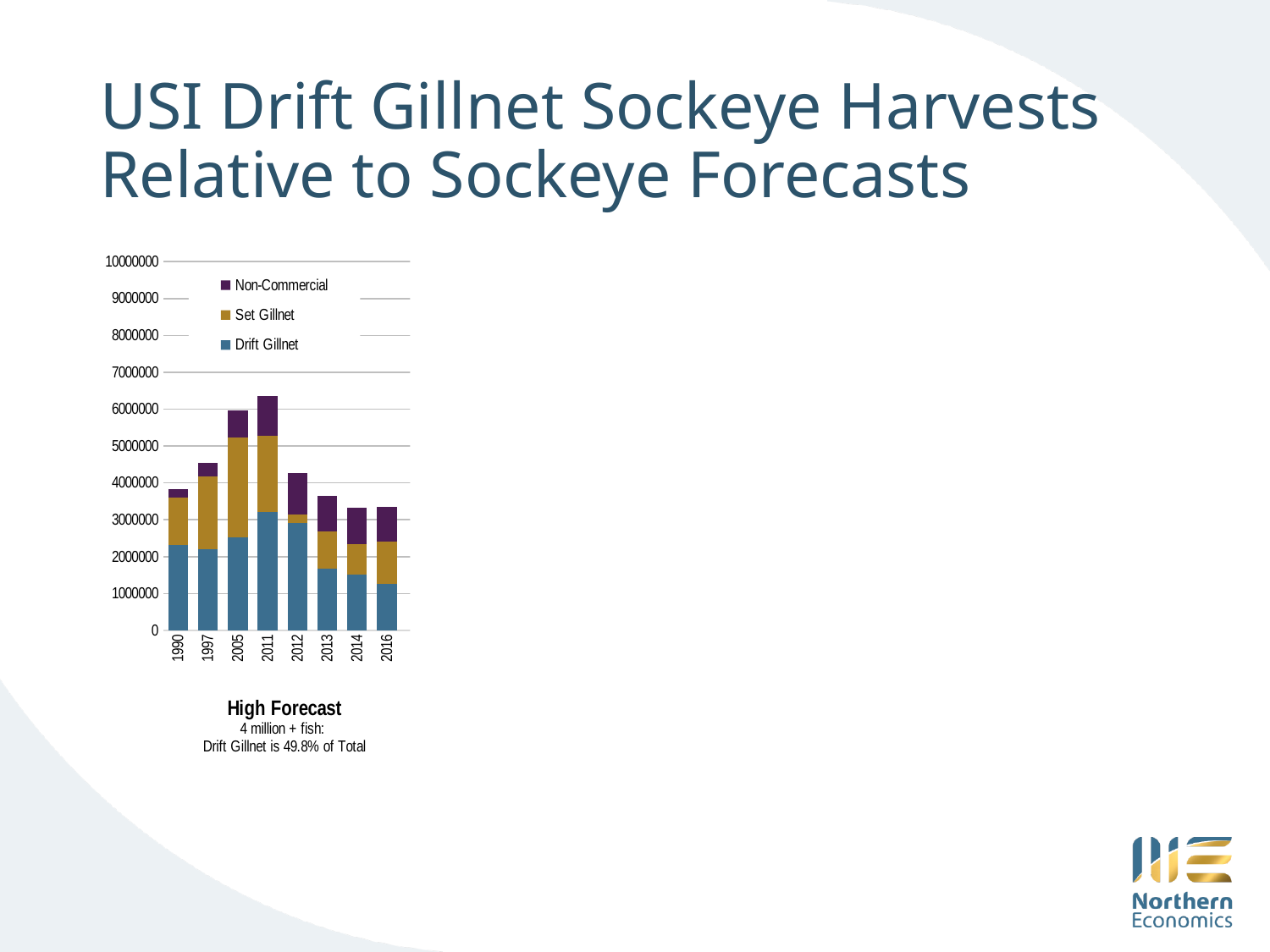
Do the total stacked bars rise or fall from 2011 to 2016? fall Is the total stacked bar for 2013 greater or less than 4000000? less Is the Drift Gillnet value for 2011 greater or less than 3000000? greater According to the caption below the chart, what share of the total is Drift Gillnet in high forecast years? 49.8% What kind of chart is shown on the slide? Stacked bar chart How many years are shown along the x axis of the chart? 8 Which year has the larger total stacked bar, 2005 or 2013? 2005 Is the total stacked bar for 2011 greater or less than 6000000? greater Which year has the larger Drift Gillnet value, 2011 or 2014? 2011 Which year has the tallest stacked bar (largest total harvest)? 2011 How many series does the chart's legend list? 3